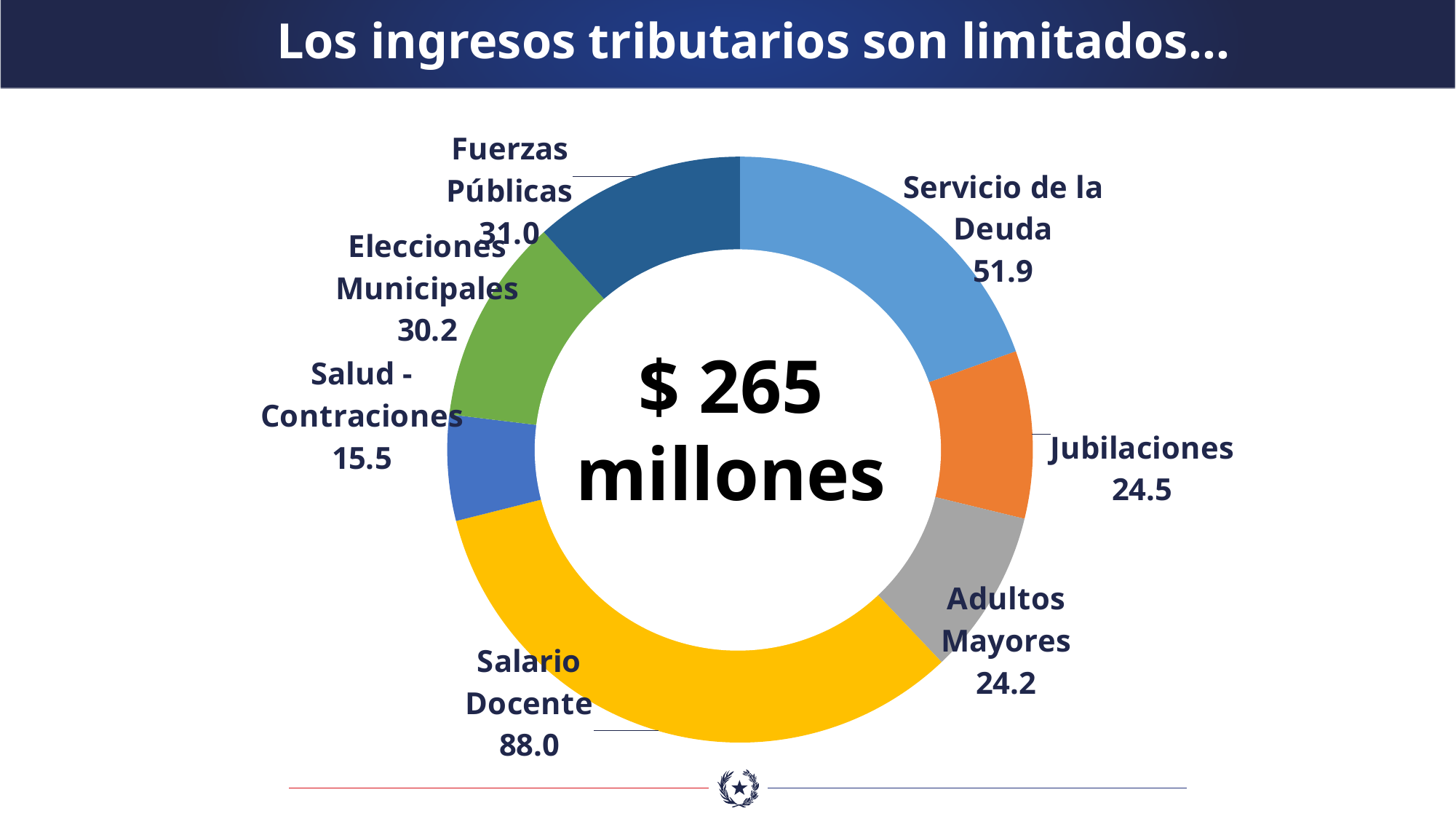
Which is larger, the value for Jubilaciones or the value for Fuerzas Públicas? Fuerzas Públicas What is the value shown for Adultos Mayores? 24.2 What is the difference between the values for Salario Docente and Servicio de la Deuda? 36.1 Which category has the smallest value in the chart? Salud - Contraciones Which category has the largest value in the chart? Salario Docente What is the difference between the values for Fuerzas Públicas and Elecciones Municipales? 0.8 What is the value shown for Servicio de la Deuda? 51.9 What is the value shown for Salud - Contraciones? 15.5 How many categories are shown in the chart? 7 What is the value shown for Salario Docente? 88.0 What text is displayed in the centre of the doughnut chart? $ 265 millones What kind of chart is shown on the slide? Doughnut (pie) chart